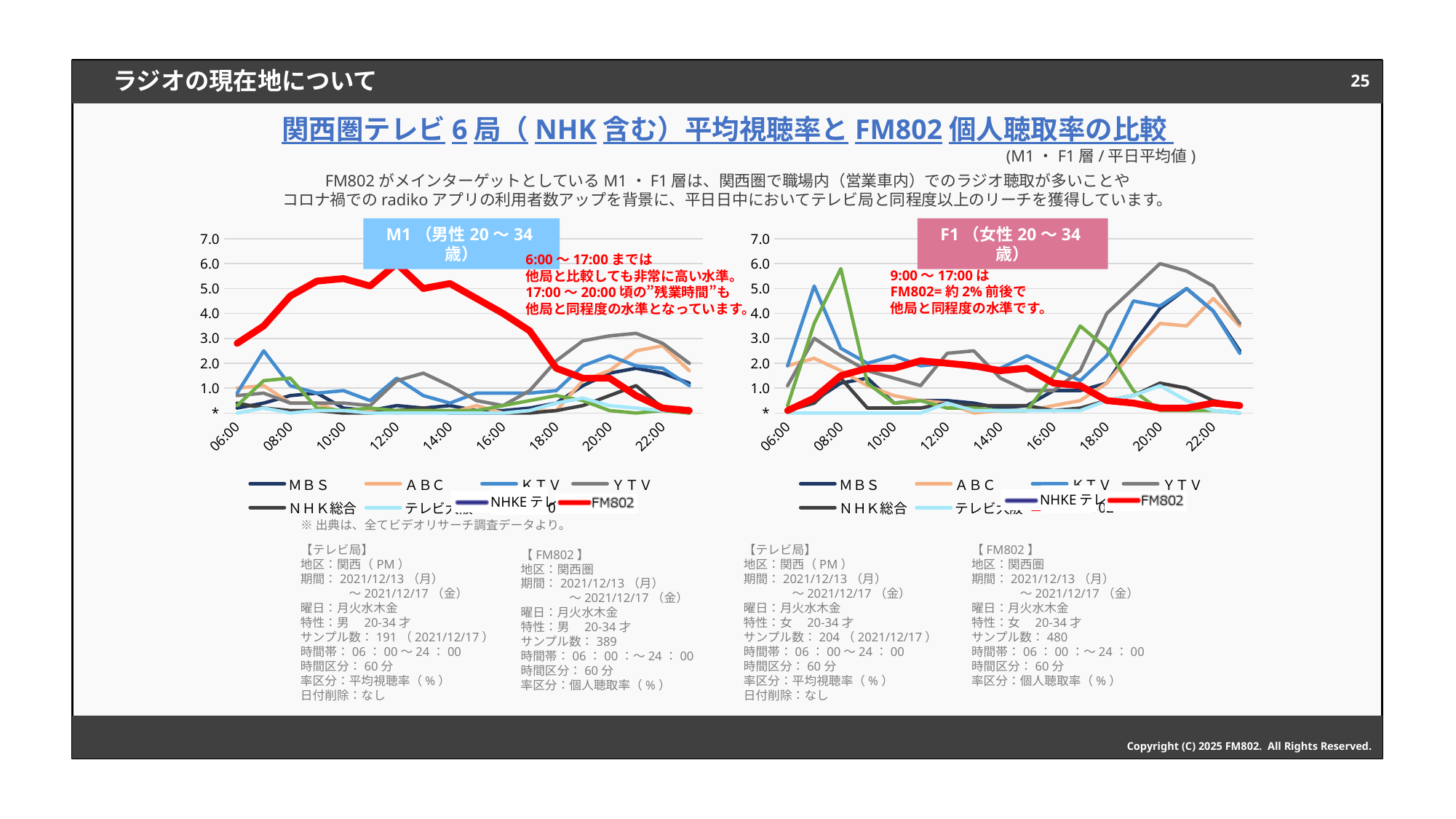
In the M1（男性20～34歳）chart, which series has the highest value at 12:00? FM802 What kind of chart is the M1（男性20～34歳）chart on the left? line chart In the M1（男性20～34歳）chart, does the FM802 line rise or fall from 12:00 to 22:00? fall How many time labels are shown on the x axis of the M1（男性20～34歳）chart? 9 In the M1（男性20～34歳）chart, is the FM802 value at 10:00 greater or less than 5.0? greater In the F1（女性20～34歳）chart, is the FM802 value at 22:00 greater or less than 1.0? less In the M1（男性20～34歳）chart, is the FM802 value at 18:00 greater or less than 2.0? less How many series does the legend of the F1（女性20～34歳）chart list? 8 What colour is the FM802 line in both charts? red In the F1（女性20～34歳）chart, which is larger at 20:00, YTV or FM802? YTV In the F1（女性20～34歳）chart, which series has the highest value at 08:00? ＮＨＫＥテレ